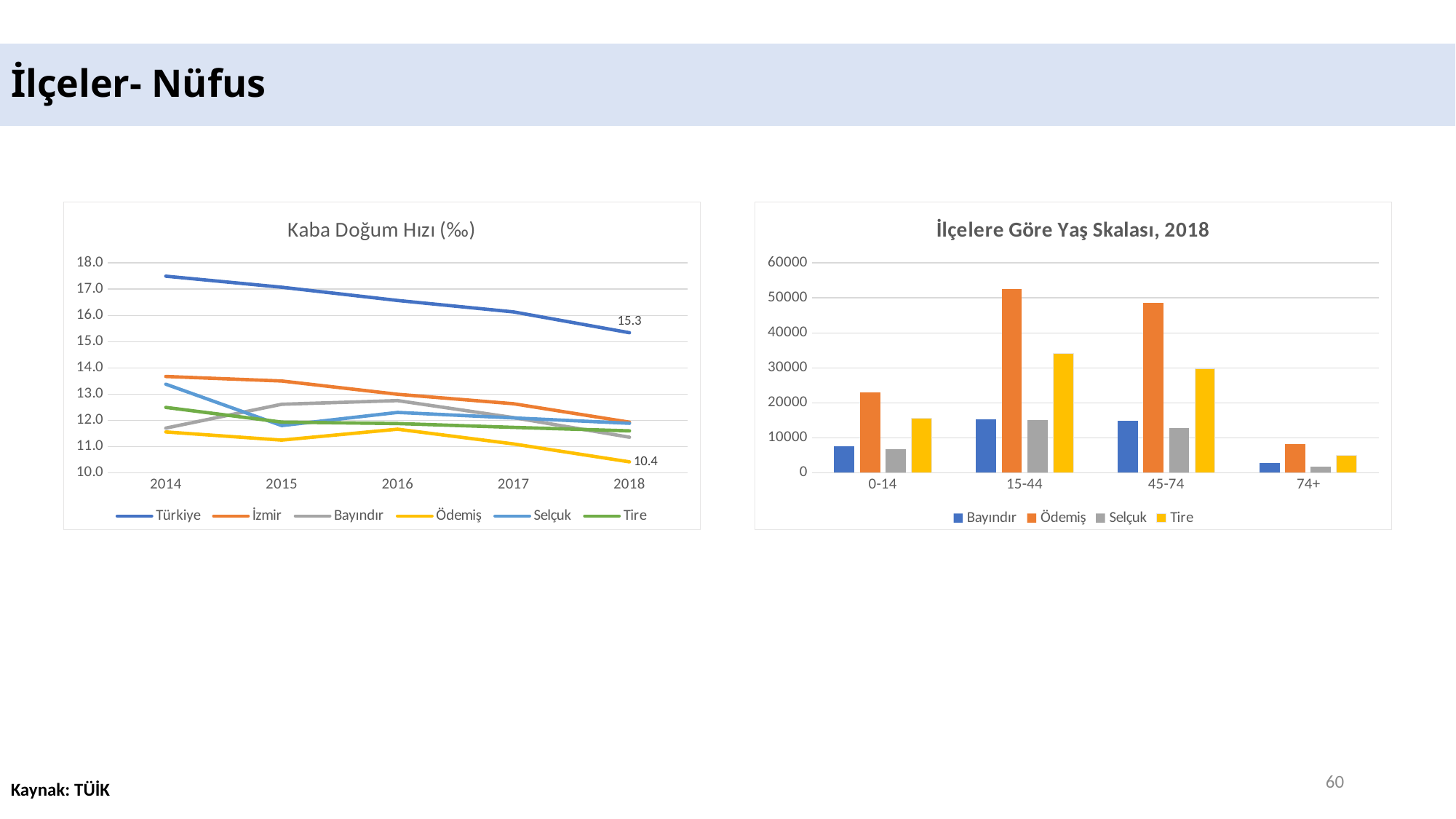
In the right chart "İlçelere Göre Yaş Skalası, 2018", is the value for Ödemiş in the 15-44 age group greater or less than 50000? greater In the left chart "Kaba Doğum Hızı (‰)", how many series does the legend list? 6 In the left chart "Kaba Doğum Hızı (‰)", how many years are shown on the x axis? 5 In the left chart "Kaba Doğum Hızı (‰)", does the Türkiye line rise or fall from 2014 to 2018? fall In the left chart "Kaba Doğum Hızı (‰)", what is the value for Ödemiş in 2018? 10.4 In the left chart "Kaba Doğum Hızı (‰)", what is the value for Türkiye in 2018? 15.3 In the right chart "İlçelere Göre Yaş Skalası, 2018", which district has the lowest value in the 74+ age group? Selçuk What kind of chart is the left chart titled "Kaba Doğum Hızı (‰)"? line chart In the left chart "Kaba Doğum Hızı (‰)", what is the difference between the 2018 values for Türkiye and Ödemiş? 4.9 In the right chart "İlçelere Göre Yaş Skalası, 2018", which district has the highest value in the 15-44 age group? Ödemiş What kind of chart is the right chart titled "İlçelere Göre Yaş Skalası, 2018"? bar chart In the right chart "İlçelere Göre Yaş Skalası, 2018", how many series does the legend list? 4